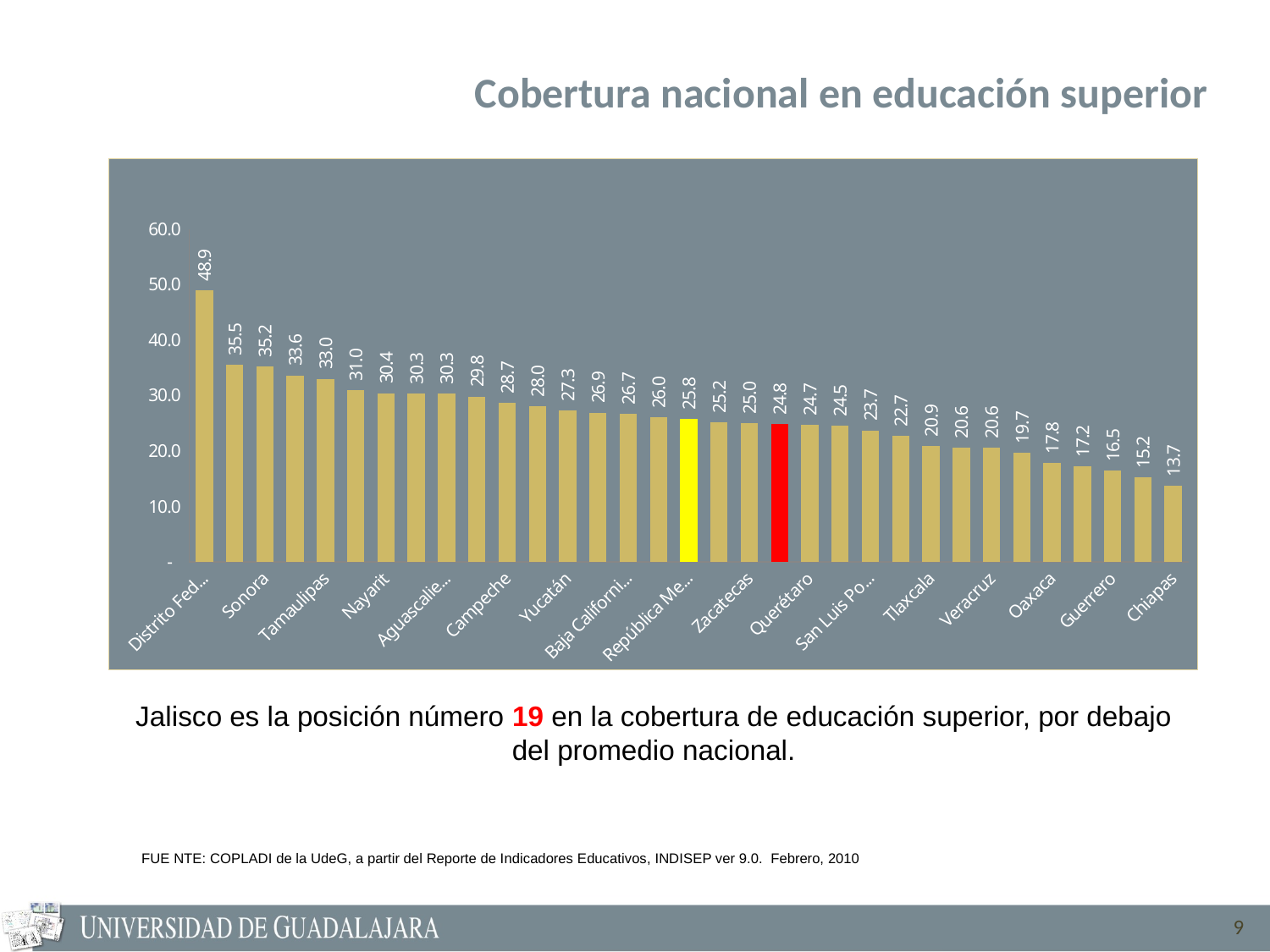
Is the value for Chiapas greater or less than 20.0? less What is the value for Chiapas? 13.7 What is the difference between the highest value (48.9) and the lowest value (13.7)? 35.2 How many bars are plotted in the chart? 33 Which category has the lowest value in the chart? Chiapas What colour is the bar for República Me... in the chart? yellow Do the values generally rise or fall from left to right along the x axis? fall Is the value for Distrito Fed... greater or less than 40.0? greater What is the value of the tallest bar (Distrito Fed...)? 48.9 What type of chart is shown on the slide? bar chart Which is larger, the value for Distrito Fed... or the value for Chiapas? Distrito Fed... Which category has the highest value in the chart? Distrito Fed...